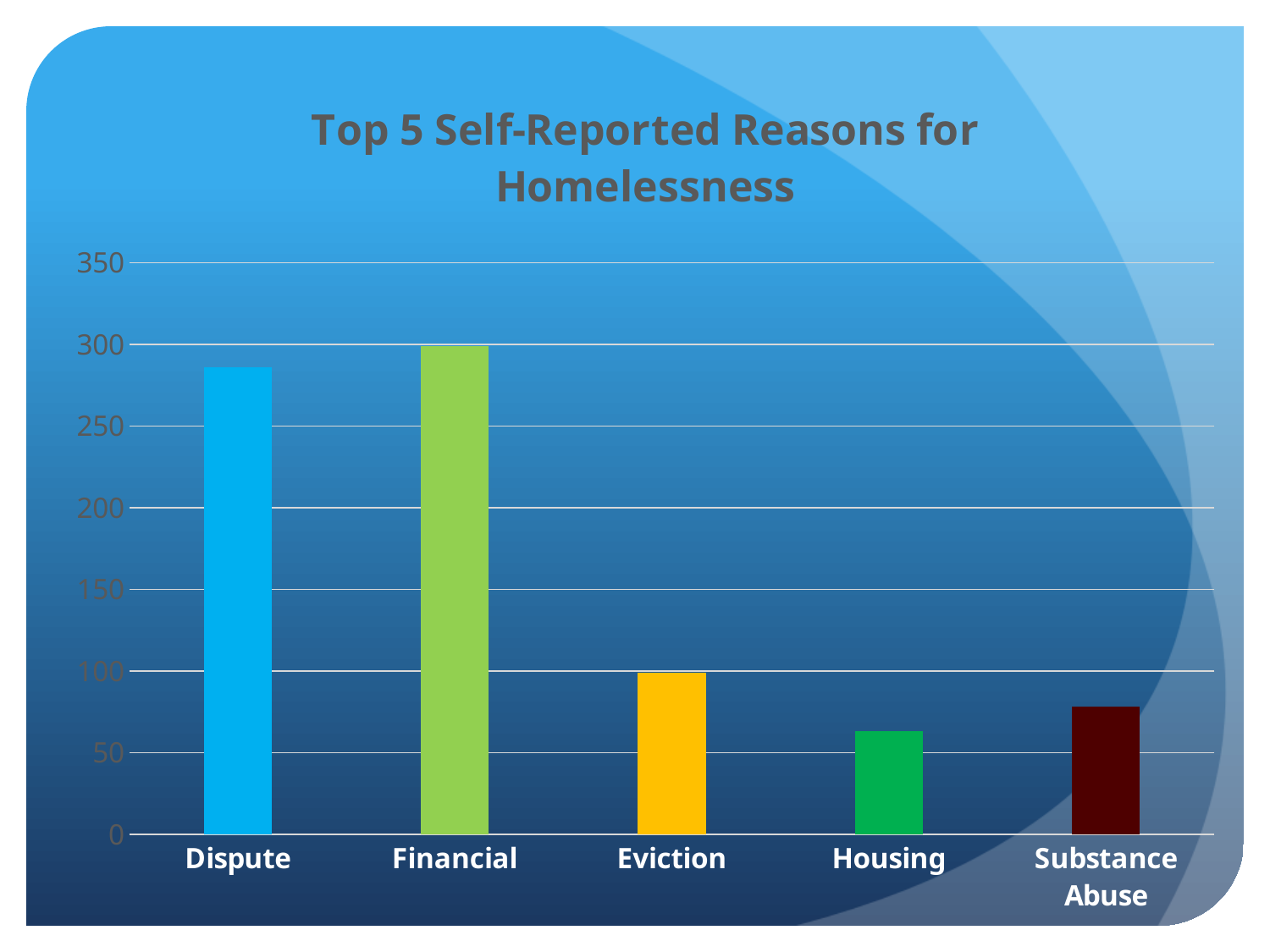
Which category has the highest value? Financial Which category has the lowest value? Housing What is the title of the chart? Top 5 Self-Reported Reasons for Homelessness Is the value for Financial greater or less than 250? greater Is the value for Substance Abuse greater or less than 50? greater Is the value for Dispute greater or less than 300? less Which is larger, the value for Housing or the value for Substance Abuse? Substance Abuse What type of chart is shown on the slide? bar chart Which is larger, the value for Eviction or the value for Substance Abuse? Eviction How many categories are shown on the x axis of the chart? 5